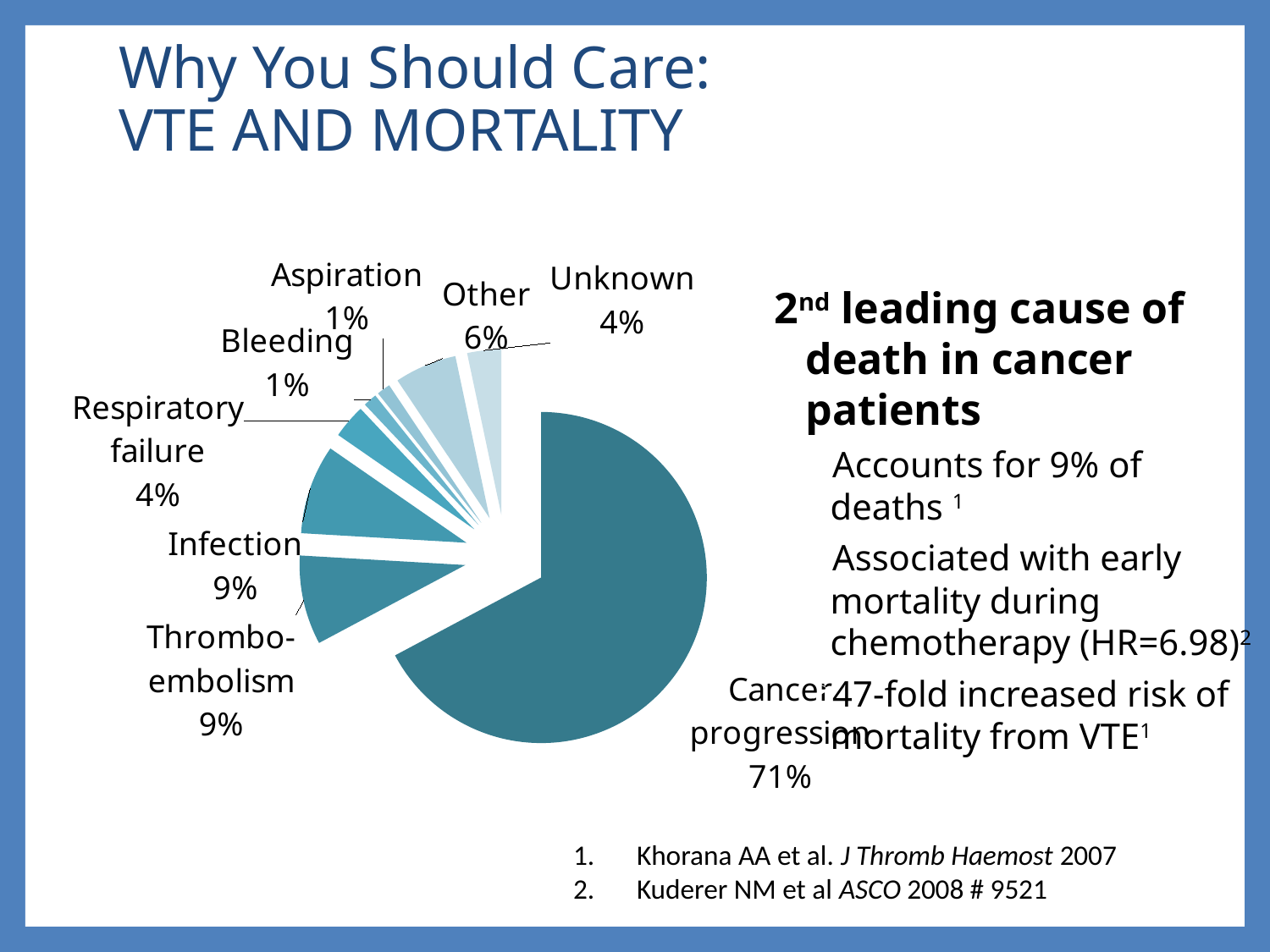
What percentage of deaths is attributed to Unknown causes? 4% What type of chart is shown on the slide? Pie chart What percentage of deaths is attributed to Infection? 9% Which cause of death has the largest slice of the pie? Cancer progression How many slices does the pie chart have? 8 What percentage of deaths is attributed to Other causes? 6% Which is larger, the share for Other or the share for Unknown? Other What percentage of deaths is attributed to Respiratory failure? 4% What percentage of deaths is attributed to Thromboembolism? 9% What percentage of deaths is attributed to Cancer progression? 71% What is the difference between the share for Cancer progression and the share for Thromboembolism? 62% What is the combined share of Bleeding and Aspiration? 2%